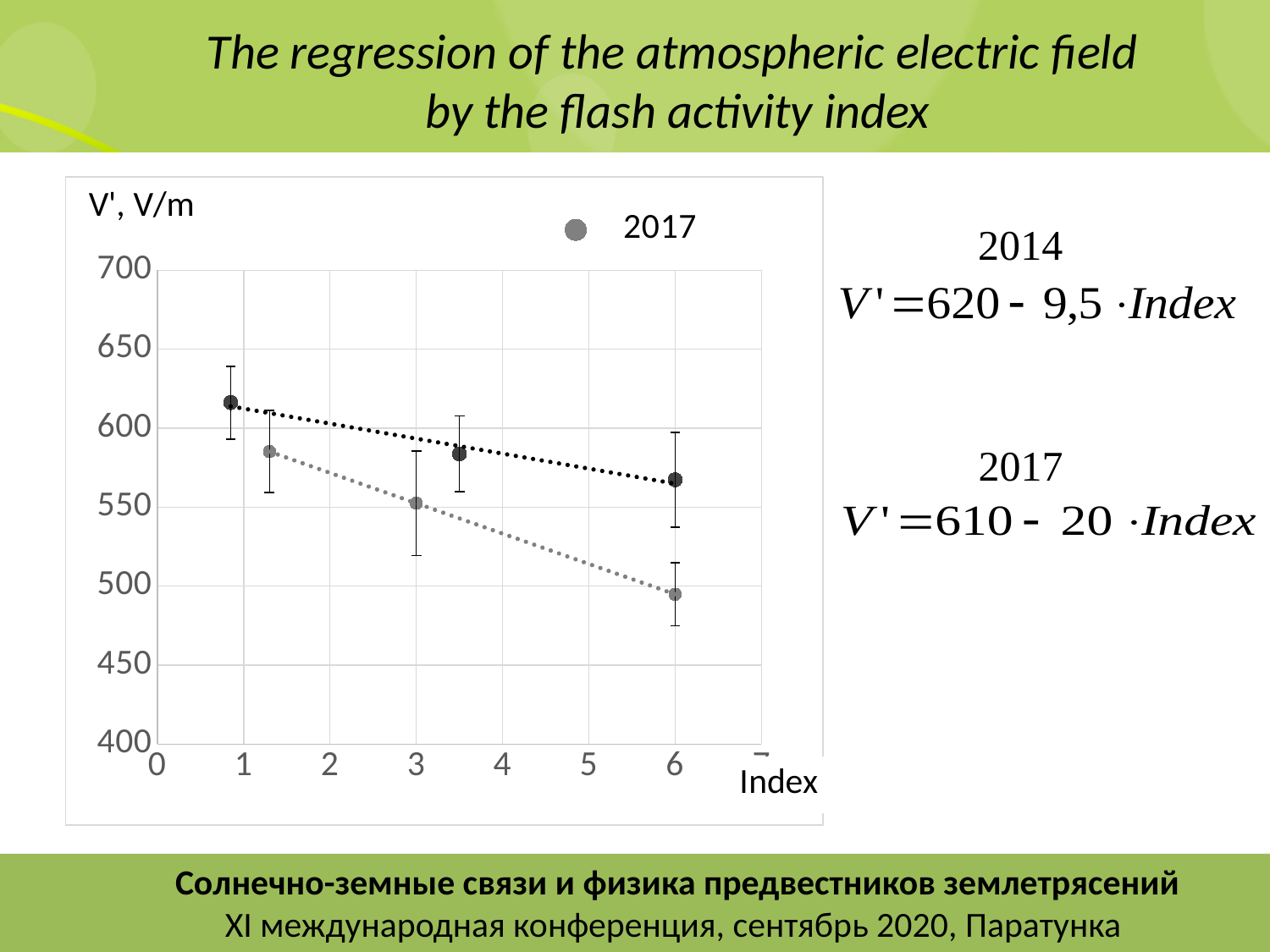
Do the values of the 2014 series (dark points) rise or fall as the Index increases? fall Is the value of the leftmost 2014 point (dark, near Index 1) greater or less than 600? greater What is the label of the horizontal axis? Index What is the label of the vertical axis? V', V/m What kind of chart is shown on the slide? scatter chart How many data points are plotted for the 2017 series? 3 Do the values of the 2017 series rise or fall as the Index increases? fall Is the value of the 2017 series at Index 6 greater or less than 550? less Is the value of the 2014 series (dark points) at Index 6 greater or less than 550? greater At which Index does the 2017 series reach its lowest value? 6 At Index 6, which series has the higher value, 2014 (dark points) or 2017 (grey points)? 2014